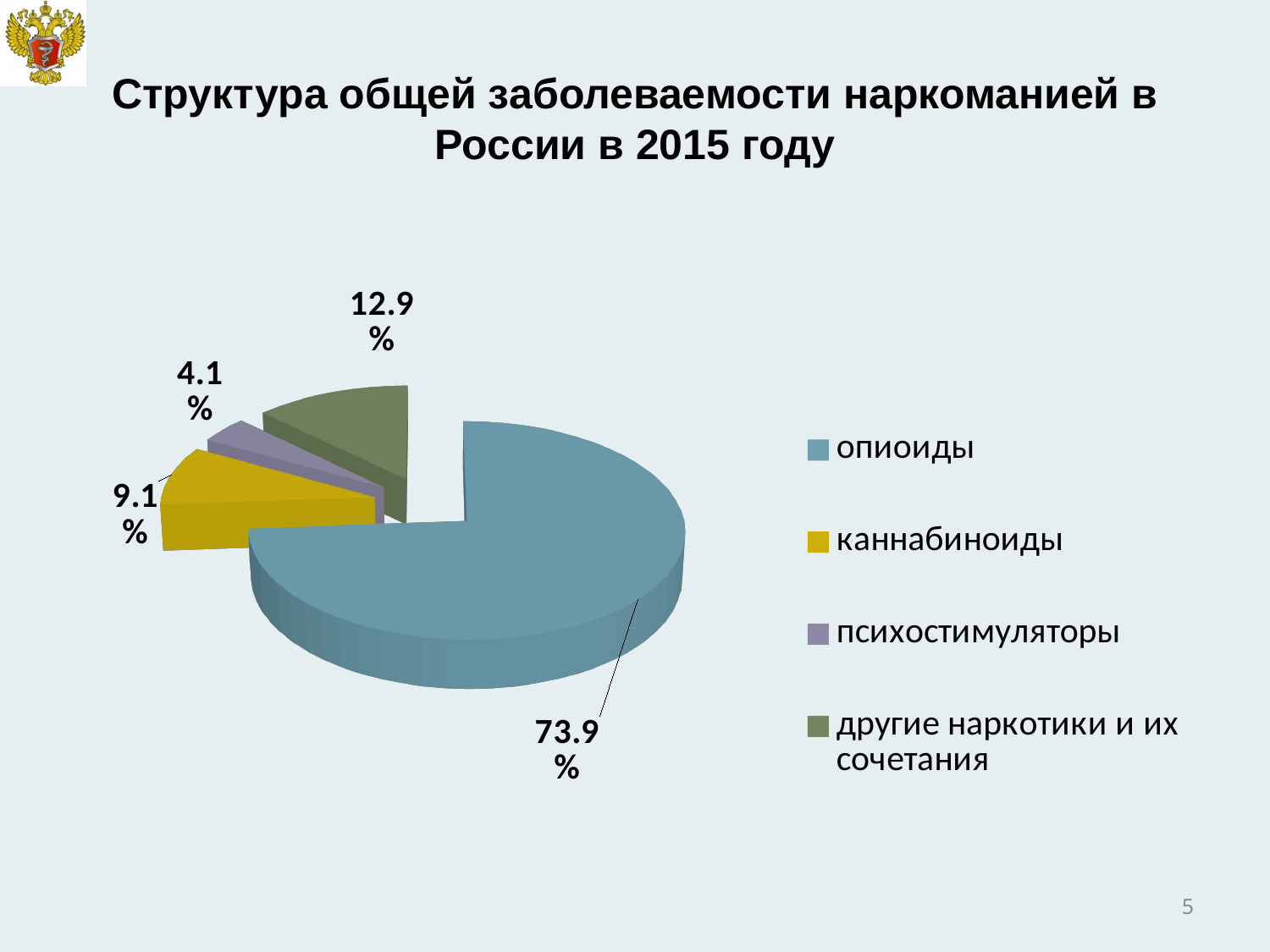
What share of the pie does другие наркотики и их сочетания account for? 12.9% What is the title of the chart on the slide? Структура общей заболеваемости наркоманией в России в 2015 году What share of the pie does каннабиноиды account for? 9.1% How many slices does the pie chart have? 4 What type of chart is shown on the slide? pie chart What is the difference in percentage points between каннабиноиды and психостимуляторы? 5 What is the difference in percentage points between опиоиды and другие наркотики и их сочетания? 61 What share of the pie does опиоиды account for? 73.9% Which category has the largest slice of the pie? опиоиды Which is larger, the slice for каннабиноиды or the slice for другие наркотики и их сочетания? другие наркотики и их сочетания Which category has the smallest slice of the pie? психостимуляторы What share of the pie does психостимуляторы account for? 4.1%